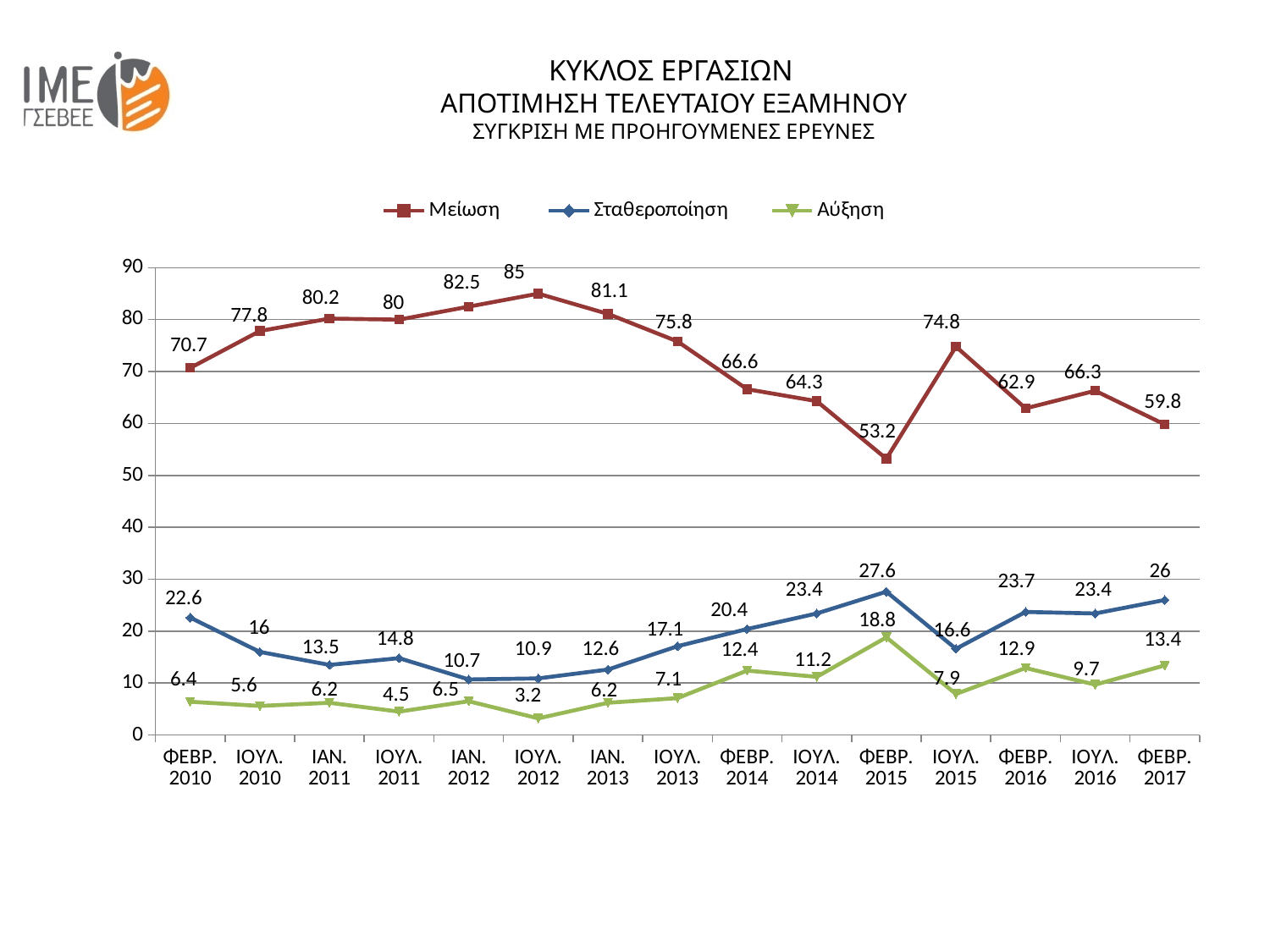
What is the value of Μείωση for ΙΟΥΛ. 2012? 85 What is the difference between the Μείωση values for ΙΟΥΛ. 2015 and ΦΕΒΡ. 2015? 21.6 What is the value of Σταθεροποίηση for ΦΕΒΡ. 2017? 26 How many series does the legend list? 3 What type of chart is shown on the slide? line chart At which time point is Αύξηση lowest? ΙΟΥΛ. 2012 Which is larger, Σταθεροποίηση for ΦΕΒΡ. 2010 or Σταθεροποίηση for ΙΑΝ. 2011? ΦΕΒΡ. 2010 How many time points are shown on the x axis? 15 At which time point is Σταθεροποίηση highest? ΦΕΒΡ. 2015 What is the value of Αύξηση for ΦΕΒΡ. 2015? 18.8 At which time point is Μείωση lowest? ΦΕΒΡ. 2015 Which series is drawn in green? Αύξηση